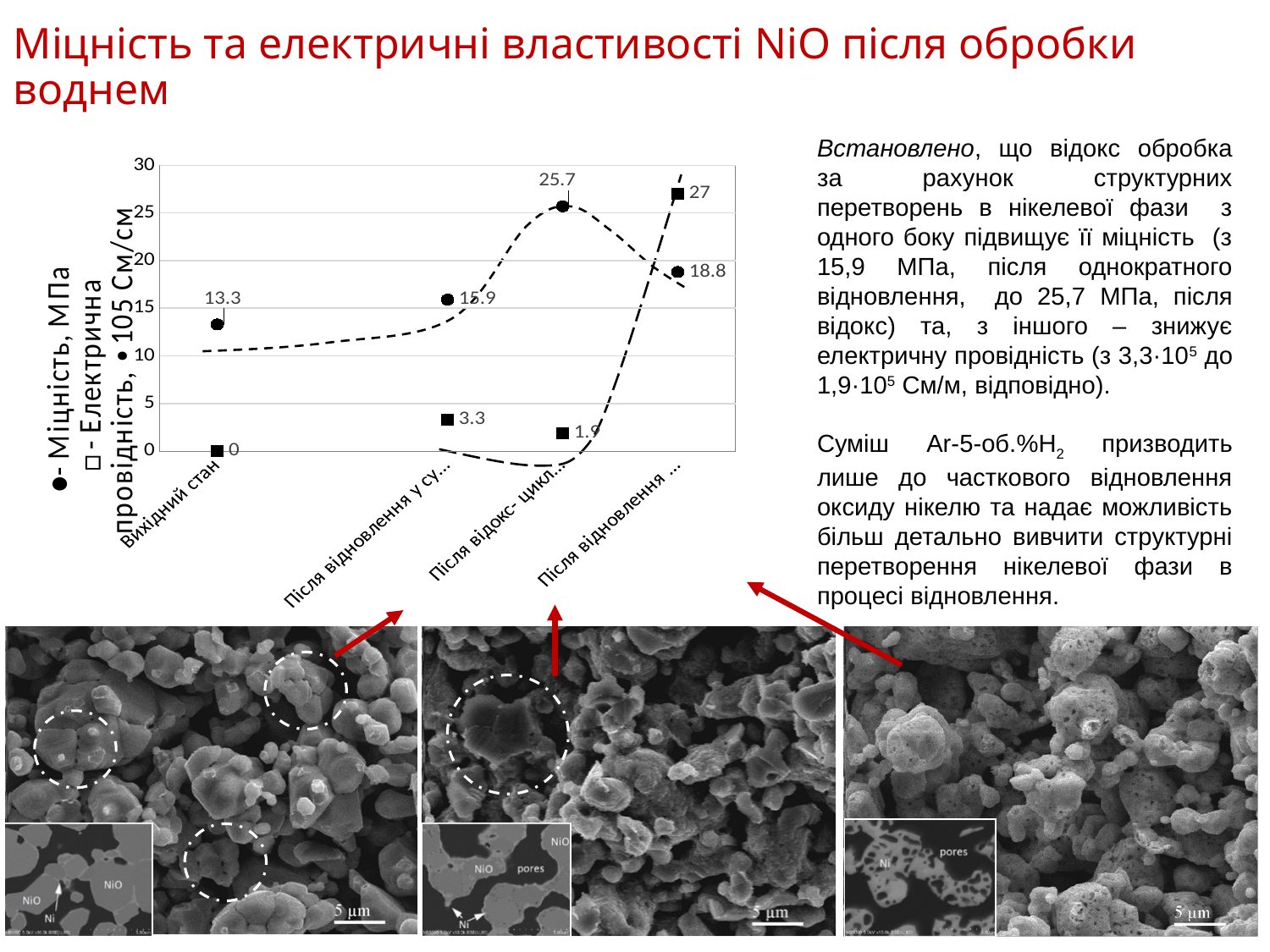
What is the strength (Міцність, МПа) value for the category "Вихідний стан"? 13.3 What is the electrical conductivity value at the fourth (last) category? 27 What is the difference between the electrical conductivity values at the second category (3.3) and the third category (1.9)? 1.4 Which is larger: the strength value at the second category (15.9) or at the fourth category (18.8)? The fourth category (18.8) Which category has the highest strength (Міцність) value? Після відокс- цикл... (third category) What is the maximum value shown on the vertical axis of the chart? 30 What is the strength value at the third category ("Після відокс- цикл...")? 25.7 Which category has the lowest strength (Міцність) value? Вихідний стан How many data series does the chart show? 2 How many categories are plotted along the x axis? 4 What is the electrical conductivity value for the category "Вихідний стан"? 0 What is the difference between the highest strength value (25.7) and the strength in "Вихідний стан" (13.3)? 12.4